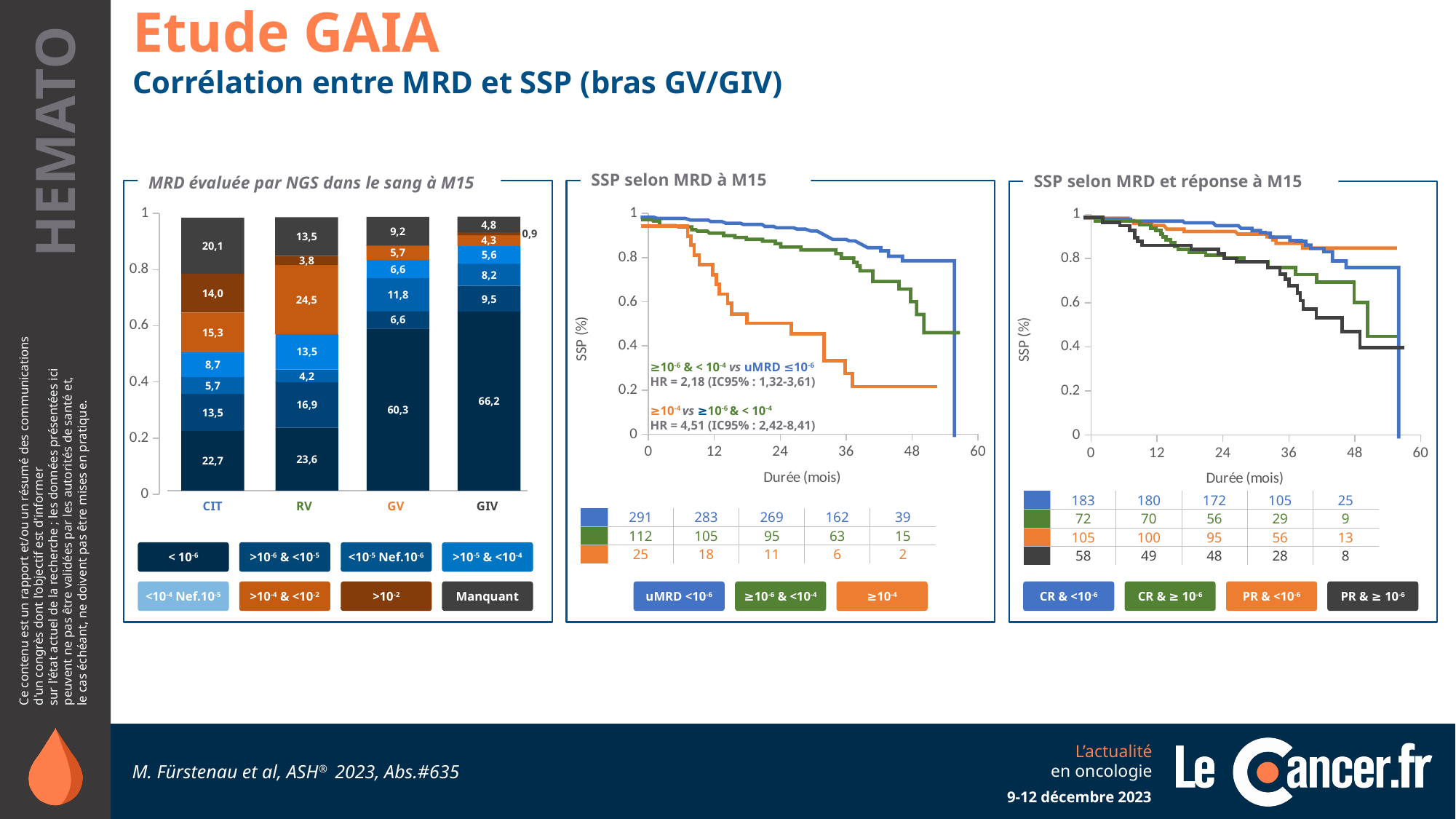
How many groups does the legend of the chart 'SSP selon MRD et réponse à M15' list? 4 In the chart 'SSP selon MRD et réponse à M15', how many patients are at risk at time 0 in the 'PR & ≥ 10⁻⁶' group? 58 In the chart 'SSP selon MRD à M15', how many patients are at risk at time 0 in the 'uMRD <10⁻⁶' group? 291 In the chart 'MRD évaluée par NGS dans le sang à M15', what is the value of the 'Manquant' segment for the CIT arm? 20,1 In the chart 'MRD évaluée par NGS dans le sang à M15', which arm has the lowest '< 10⁻⁶' value? CIT In the chart 'MRD évaluée par NGS dans le sang à M15', what is the value of the '< 10⁻⁶' segment for the GIV arm? 66,2 How many arms (categories) are shown on the x axis of the chart 'MRD évaluée par NGS dans le sang à M15'? 4 In the chart 'MRD évaluée par NGS dans le sang à M15', which arm has the larger 'Manquant' value, CIT or RV? CIT In the chart 'SSP selon MRD à M15', is the SSP value of the '≥10⁻⁴' curve at 24 months greater or less than 0.6? less In the chart 'MRD évaluée par NGS dans le sang à M15', what is the difference between the '< 10⁻⁶' values of GIV and GV? 5,9 What kind of chart is 'MRD évaluée par NGS dans le sang à M15'? Stacked bar chart In the chart 'MRD évaluée par NGS dans le sang à M15', which arm has the highest '< 10⁻⁶' value? GIV